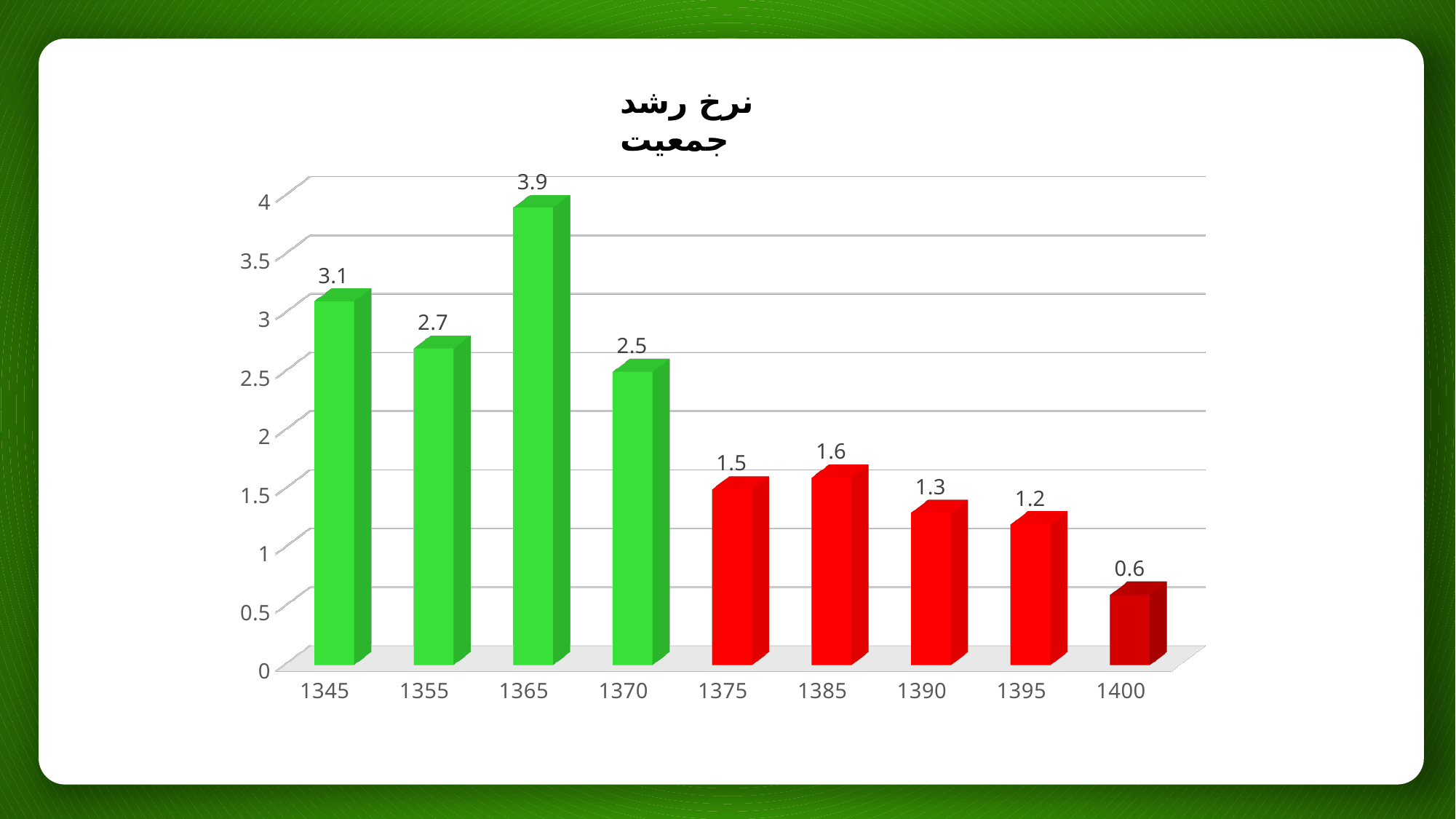
What kind of chart is this? bar chart Which category has the lowest value? 1400 Which category has the highest value? 1365 What colour are the bars for 1375 through 1400? red How many categories are shown on the x axis? 9 What is the value for 1365? 3.9 What is the value for 1400? 0.6 What is the value for 1385? 1.6 What is the difference between the values for 1345 and 1370? 0.6 Which is larger, the value for 1375 or the value for 1385? 1385 Do the values generally rise or fall from 1370 to 1400? fall Is the value for 1355 greater or less than 2.5? greater